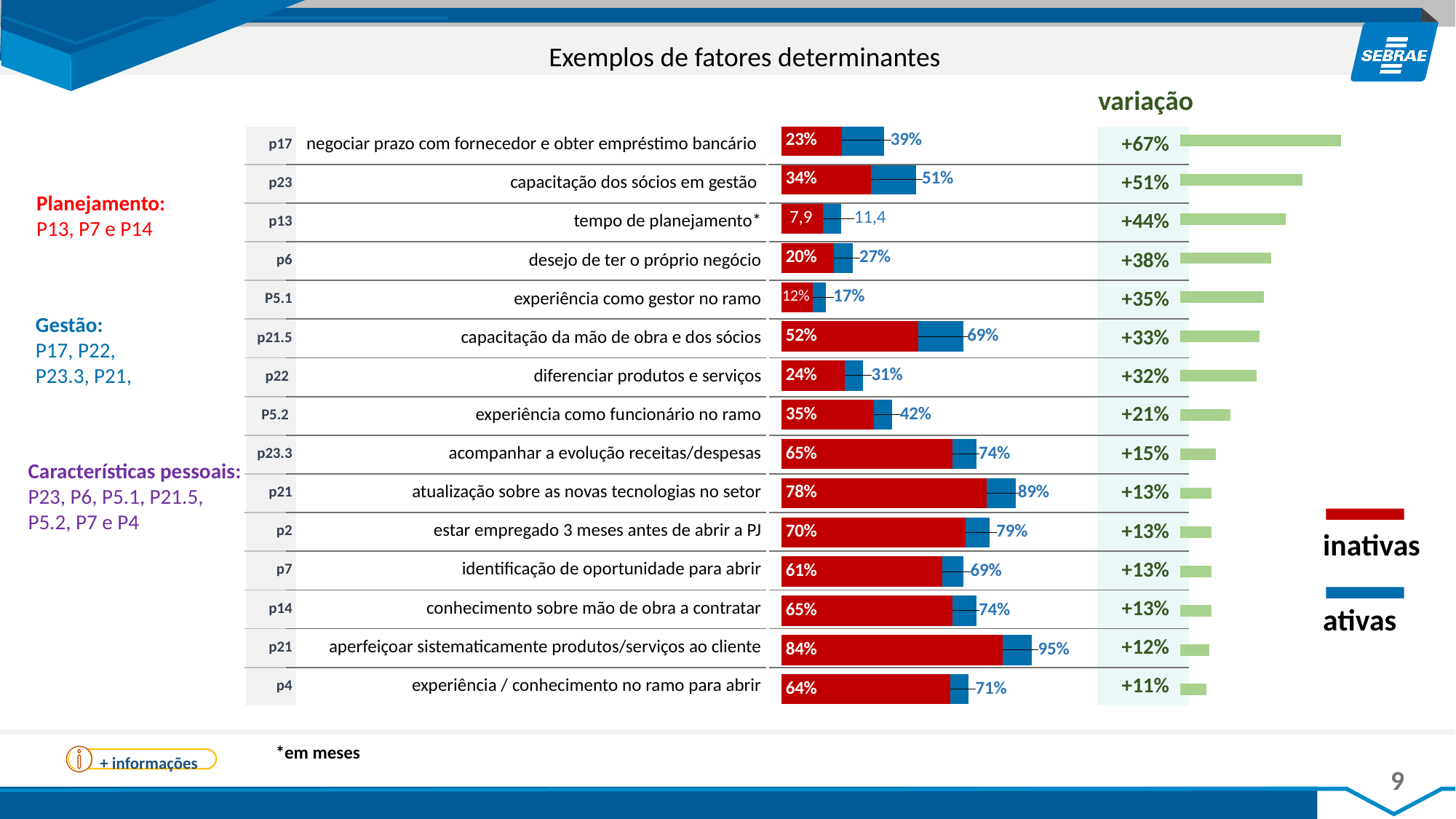
For 'capacitação da mão de obra e dos sócios', how many percentage points higher is the 'ativas' value than the 'inativas' value? 17 percentage points How many series does the legend list? 2 What kind of chart is shown on the slide? Bar chart Which factor has the highest 'variação'? negociar prazo com fornecedor e obter empréstimo bancário (+67%) Which factor has the lowest 'variação'? experiência / conhecimento no ramo para abrir (+11%) What is the value for 'inativas' for 'desejo de ter o próprio negócio'? 20% What is the 'variação' shown for 'experiência como gestor no ramo'? +35% Which factor has the highest 'ativas' value? aperfeiçoar sistematicamente produtos/serviços ao cliente (95%) Which series is shown in red according to the legend? inativas Which has the larger 'inativas' value: 'estar empregado 3 meses antes de abrir a PJ' or 'identificação de oportunidade para abrir'? estar empregado 3 meses antes de abrir a PJ How many factors (rows) are plotted in the chart? 15 What is the value for 'ativas' for 'capacitação dos sócios em gestão'? 51%